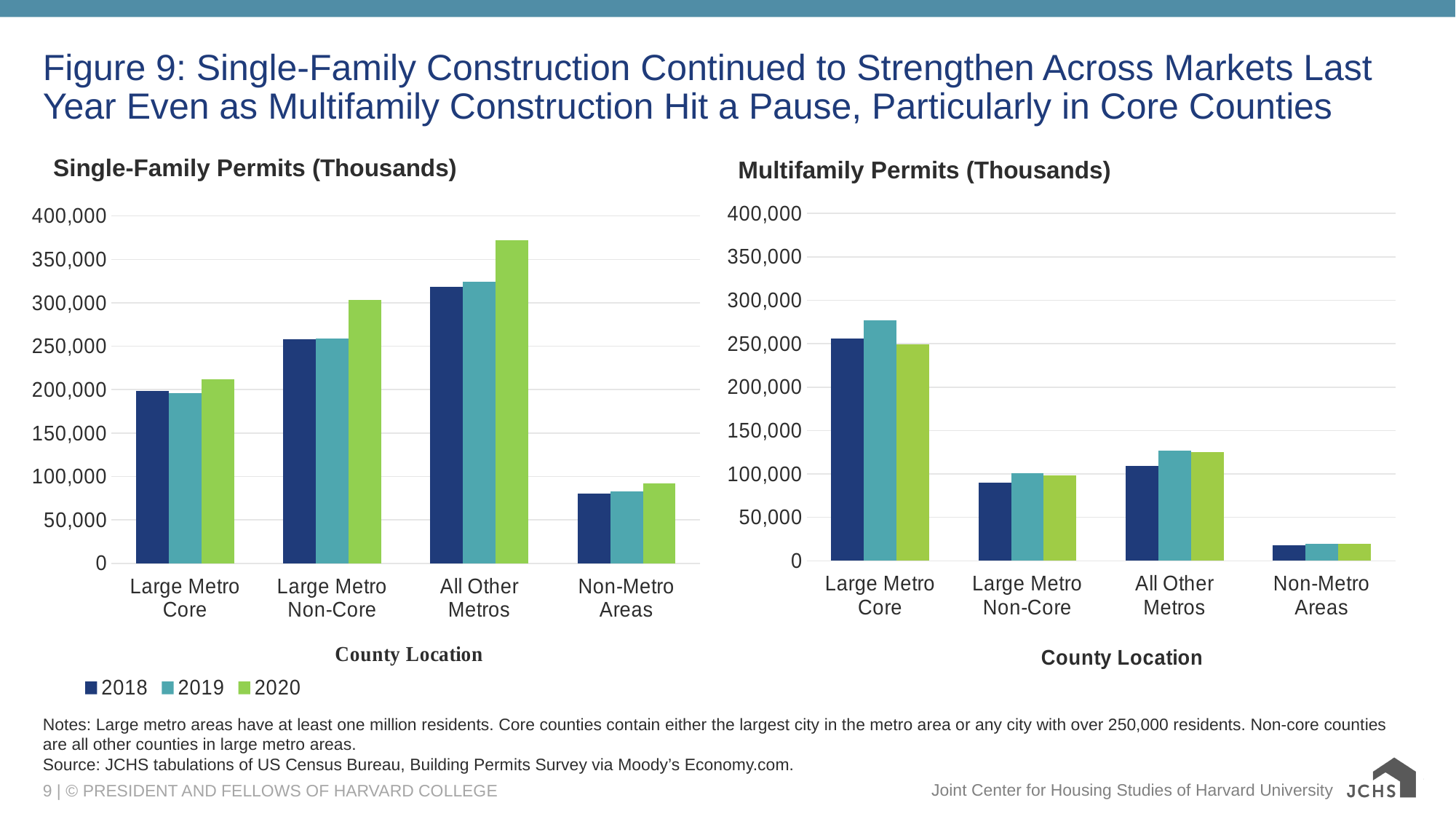
In the Multifamily Permits (Thousands) chart, how many county location categories are shown? 4 In the Single-Family Permits (Thousands) chart, for Large Metro Non-Core, which is larger: the 2018 value or the 2020 value? 2020 In the Multifamily Permits (Thousands) chart, is the 2019 value for Large Metro Core greater or less than 250,000? greater In the Single-Family Permits (Thousands) chart, is the 2020 value for All Other Metros greater or less than 350,000? greater In the Multifamily Permits (Thousands) chart, for Large Metro Core, which is larger: the 2019 value or the 2020 value? 2019 In the Multifamily Permits (Thousands) chart, which county location has the lowest 2018 value? Non-Metro Areas What are the three entries in the legend? 2018, 2019, 2020 What kind of chart is the Single-Family Permits (Thousands) chart? bar chart In the Single-Family Permits (Thousands) chart, which county location has the highest 2020 value? All Other Metros How many series does the legend list for the charts? 3 In the Multifamily Permits (Thousands) chart, which county location has the highest 2020 value? Large Metro Core In the Single-Family Permits (Thousands) chart, is the 2018 value for Non-Metro Areas greater or less than 100,000? less